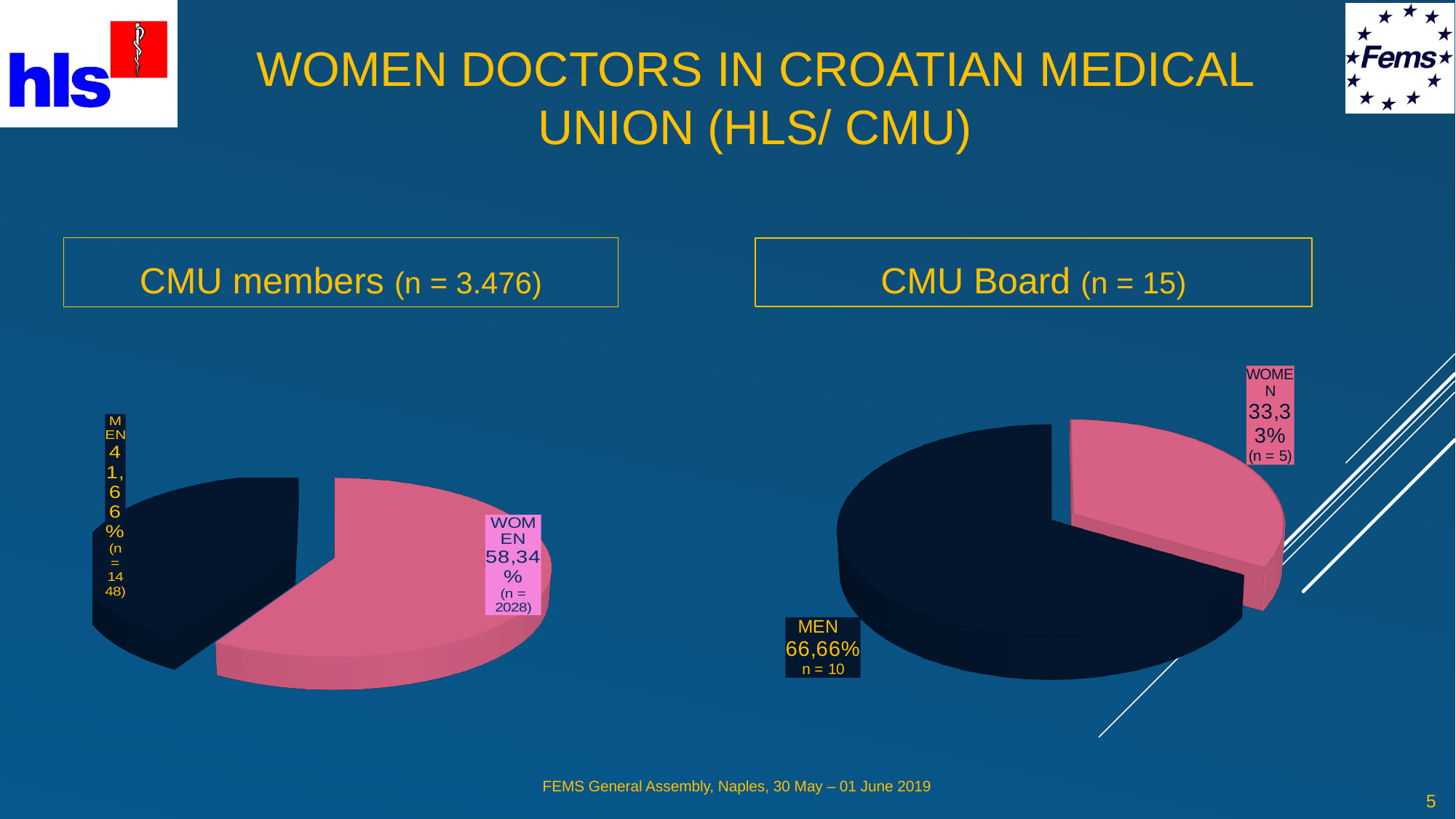
In the CMU members chart, is the share of women greater or less than 50%? greater In the CMU members chart, which group has the larger share? WOMEN In the CMU members chart, how many members are women (n)? 2028 In the CMU Board chart, what is the difference in percentage points between men and women? 33,33 In the CMU Board chart, what percentage of the board are women? 33,33% In the CMU members chart, what percentage of members are women? 58,34% In the CMU members chart, what percentage of members are men? 41,66% In the CMU Board chart, which group has the smaller share? WOMEN In the CMU Board chart, what percentage of the board are men? 66,66% How many slices does the CMU members pie chart have? 2 In the CMU Board chart, how many board members are men (n)? 10 What kind of chart is used for the CMU Board data? Pie chart